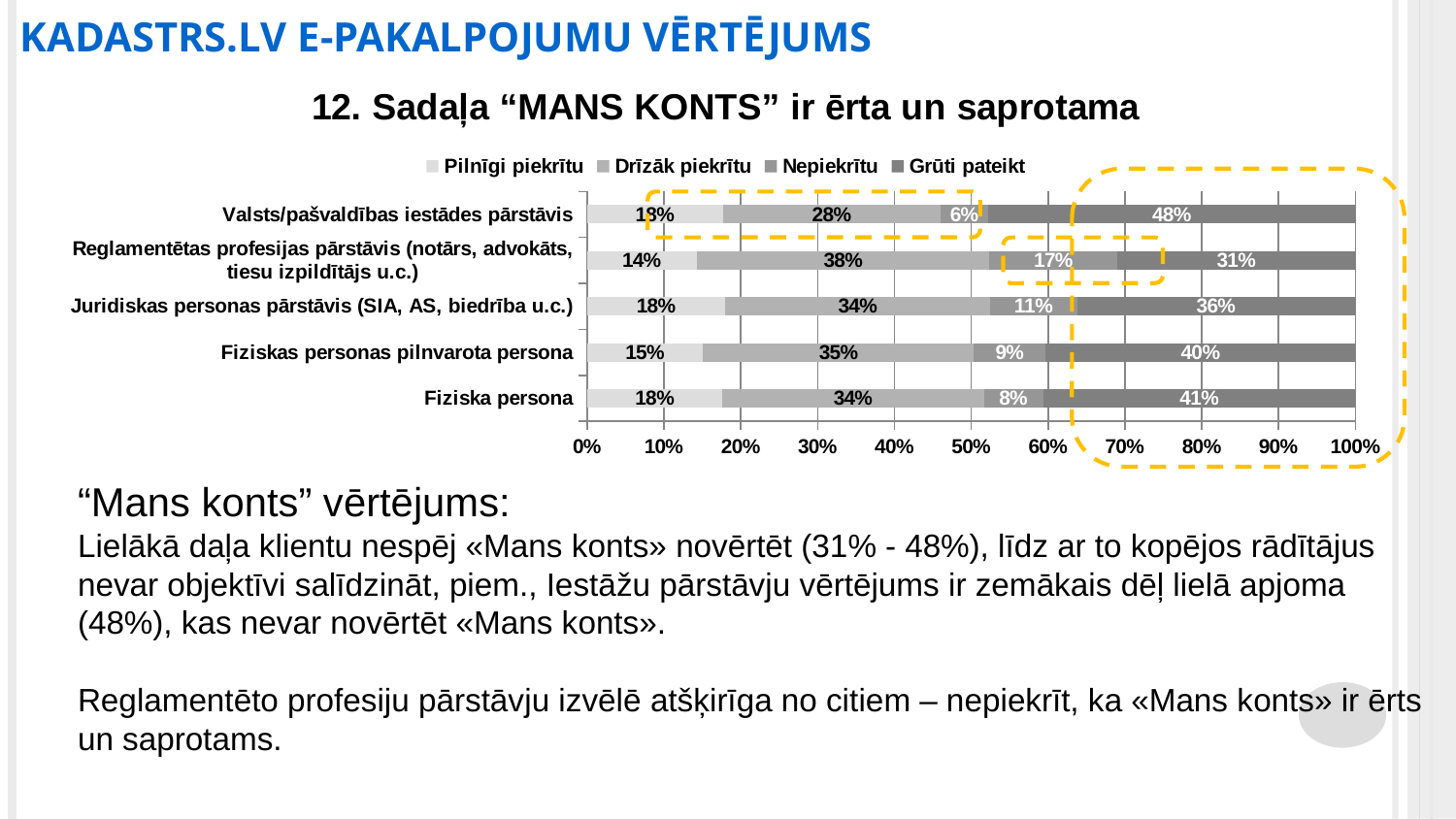
Which is larger: the "Drīzāk piekrītu" value for "Reglamentētas profesijas pārstāvis (notārs, advokāts, tiesu izpildītājs u.c.)" or for "Juridiskas personas pārstāvis (SIA, AS, biedrība u.c.)"? Reglamentētas profesijas pārstāvis (notārs, advokāts, tiesu izpildītājs u.c.) What is the "Nepiekrītu" value for "Reglamentētas profesijas pārstāvis (notārs, advokāts, tiesu izpildītājs u.c.)"? 17% What is the "Drīzāk piekrītu" value for "Fiziskas personas pilnvarota persona"? 35% How many series does the legend list? 4 What is the title of the chart? 12. Sadaļa “MANS KONTS” ir ērta un saprotama What type of chart is shown on the slide? stacked bar chart How many categories are shown on the chart? 5 Which category has the lowest "Grūti pateikt" value? Reglamentētas profesijas pārstāvis (notārs, advokāts, tiesu izpildītājs u.c.) What is the "Grūti pateikt" value for "Valsts/pašvaldības iestādes pārstāvis"? 48% What is the "Pilnīgi piekrītu" value for "Fiziska persona"? 18% Which category has the highest "Nepiekrītu" value? Reglamentētas profesijas pārstāvis (notārs, advokāts, tiesu izpildītājs u.c.) What is the difference between the "Grūti pateikt" values for "Valsts/pašvaldības iestādes pārstāvis" and "Fiziska persona"? 7%